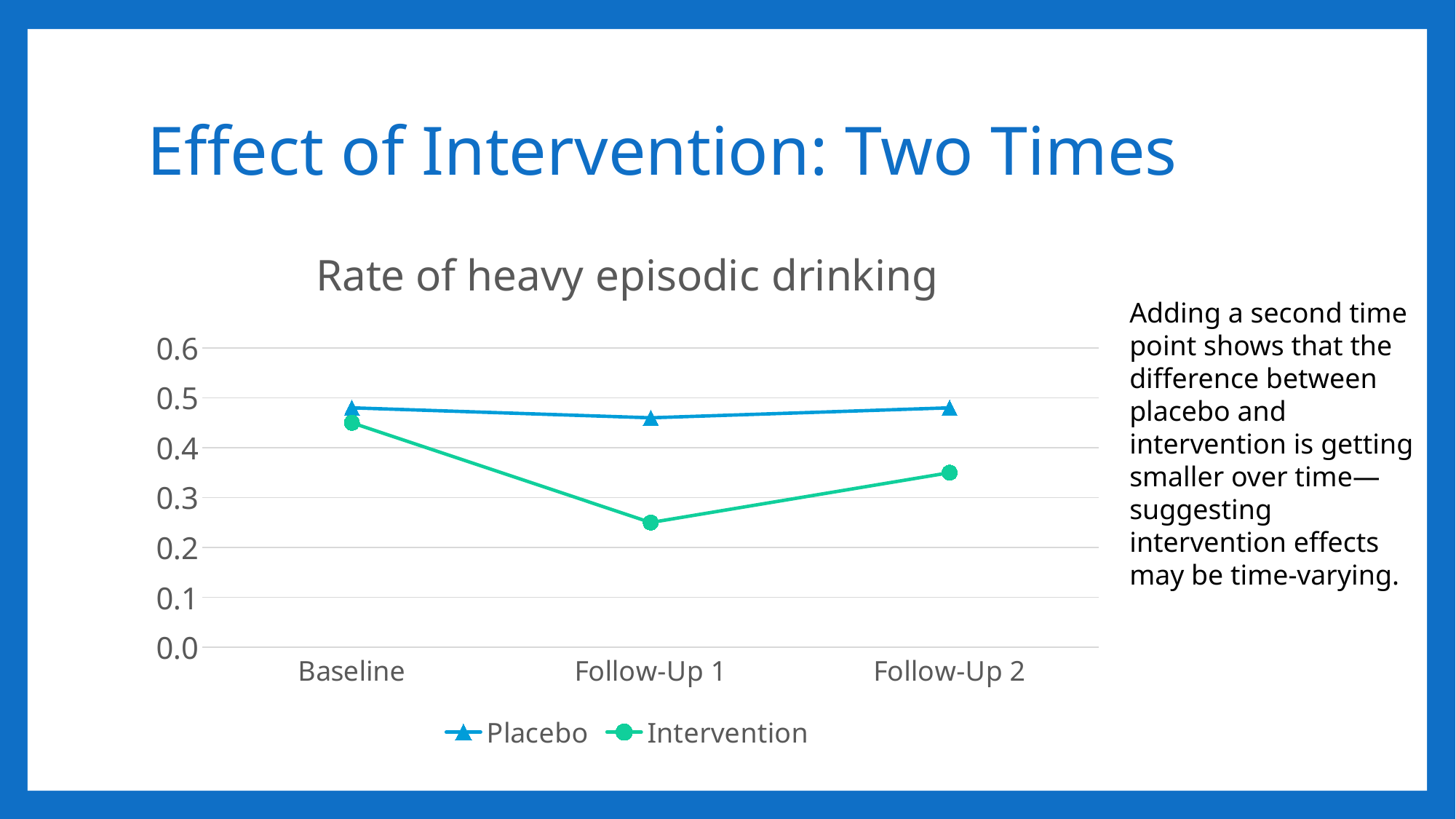
At which time point is the Intervention series lowest? Follow-Up 1 Which series is drawn with triangle markers? Placebo How many series does the legend list? 2 How many time points are shown on the x axis? 3 Does the Intervention series rise or fall from Baseline to Follow-Up 1? fall What kind of chart is shown on the slide? line chart At Follow-Up 1, which series has the higher value, Placebo or Intervention? Placebo Is the Placebo value at Follow-Up 1 greater or less than 0.5? less Is the Intervention value at Follow-Up 1 greater or less than 0.3? less What is the title of the chart? Rate of heavy episodic drinking Is the Placebo value at Baseline greater or less than 0.4? greater